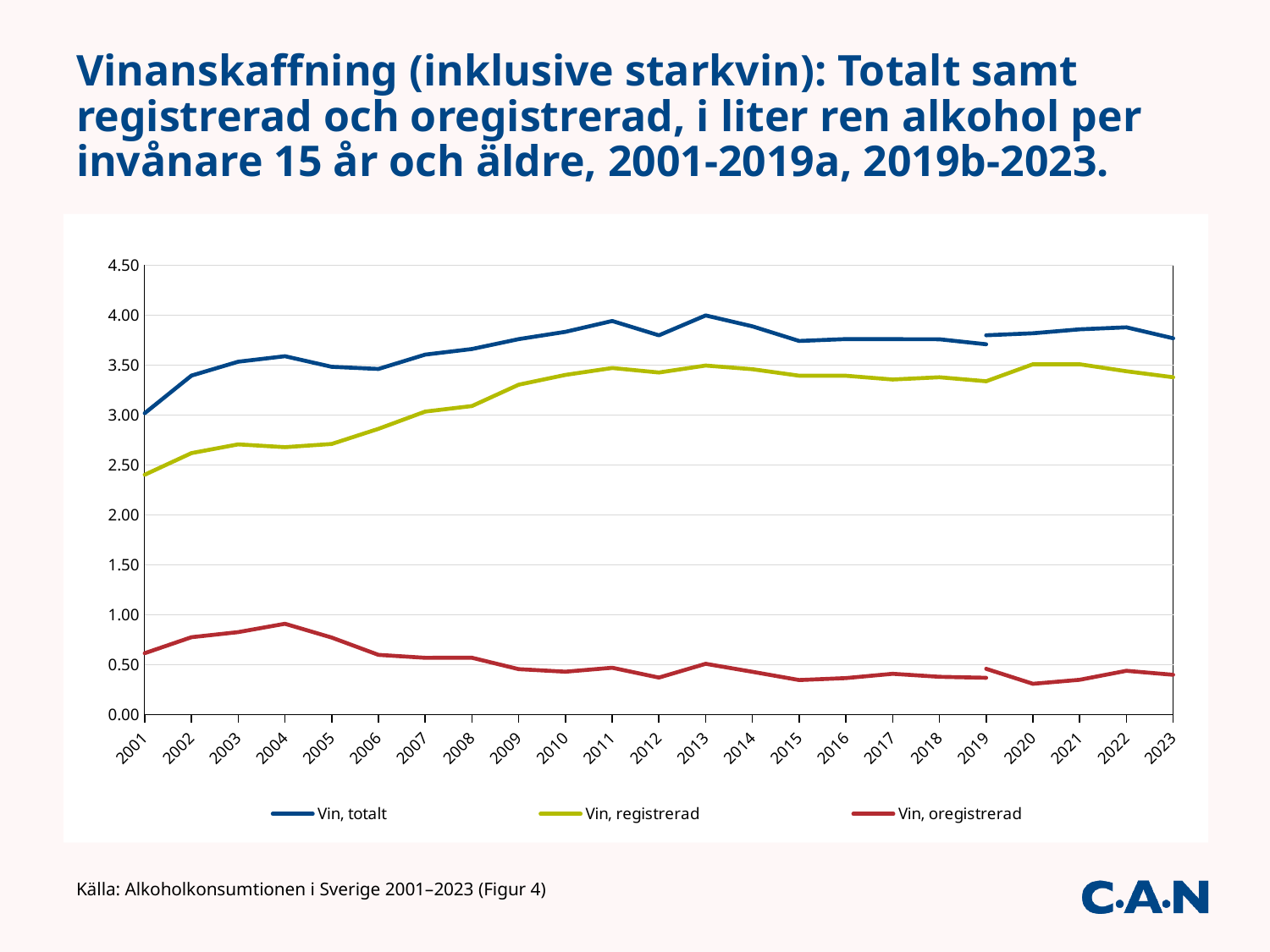
In which year is the value for Vin, totalt lowest? 2001 Is the value for Vin, registrerad in 2001 greater or less than 2.50? less What is the source given below the chart? Alkoholkonsumtionen i Sverige 2001–2023 (Figur 4) Which series is shown in red in the legend? Vin, oregistrerad Does the value for Vin, registrerad rise or fall from 2001 to 2011? rise How many series does the legend list? 3 In which year is the value for Vin, oregistrerad highest? 2004 What kind of chart is shown on the slide? line chart Is the value for Vin, totalt in 2015 greater or less than 3.50? greater Is the value for Vin, oregistrerad in 2004 greater or less than 1.00? less Which is larger for Vin, oregistrerad: the value in 2002 or the value in 2012? 2002 How many years are shown on the x axis? 23